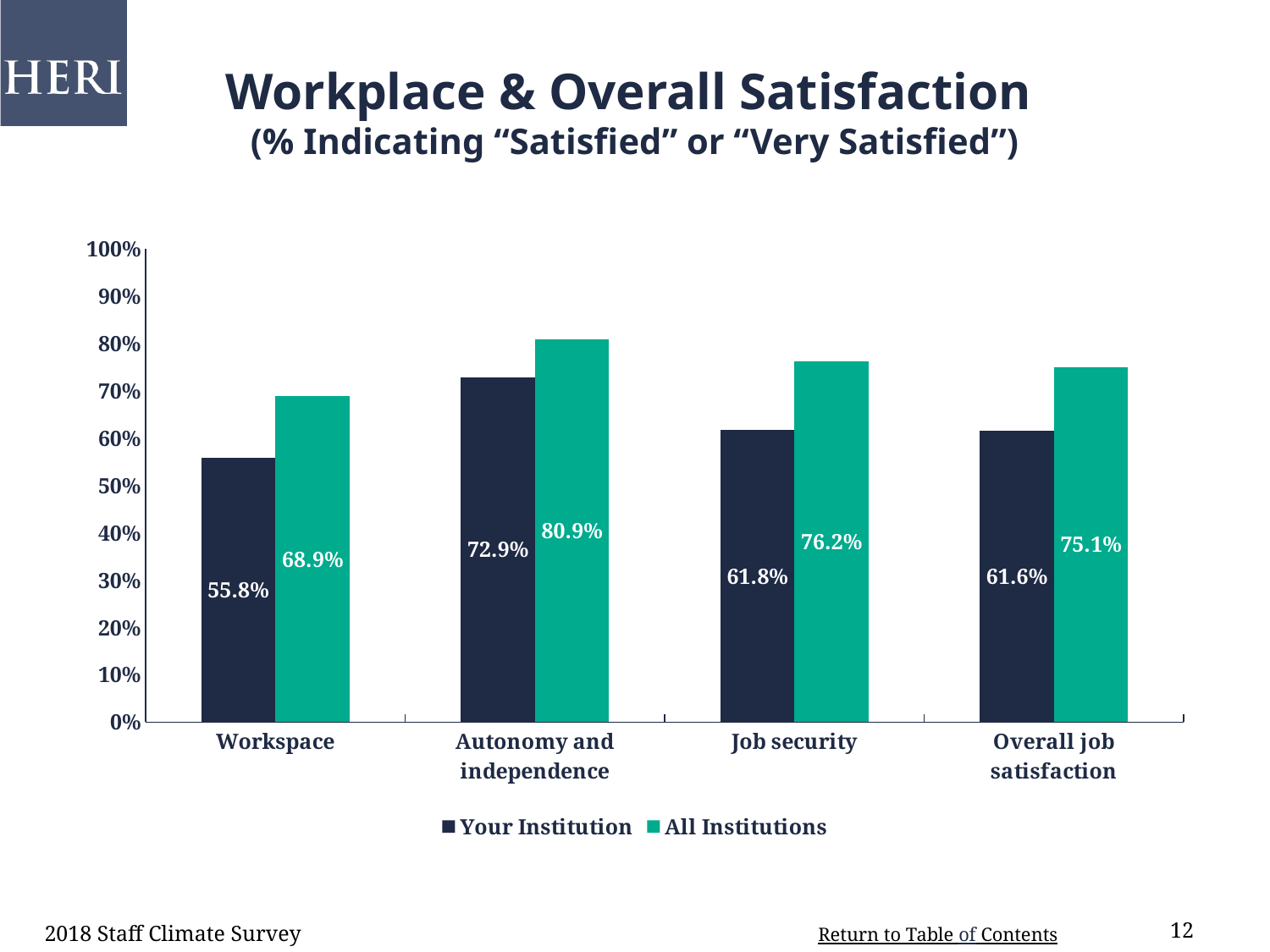
What is the difference between All Institutions and Your Institution in the Job security category? 14.4% Which category has the lowest value for Your Institution? Workspace What is the value for Your Institution in the Job security category? 61.8% What is the value for All Institutions in the Autonomy and independence category? 80.9% What kind of chart is shown on the slide? Bar chart Which is larger in the Workspace category: Your Institution or All Institutions? All Institutions Which category has the highest value for All Institutions? Autonomy and independence How many series does the legend list? 2 Is the value for Your Institution in the Autonomy and independence category greater or less than 70%? greater How many categories are shown on the x axis? 4 What is the value for All Institutions in the Overall job satisfaction category? 75.1% What is the value for Your Institution in the Workspace category? 55.8%